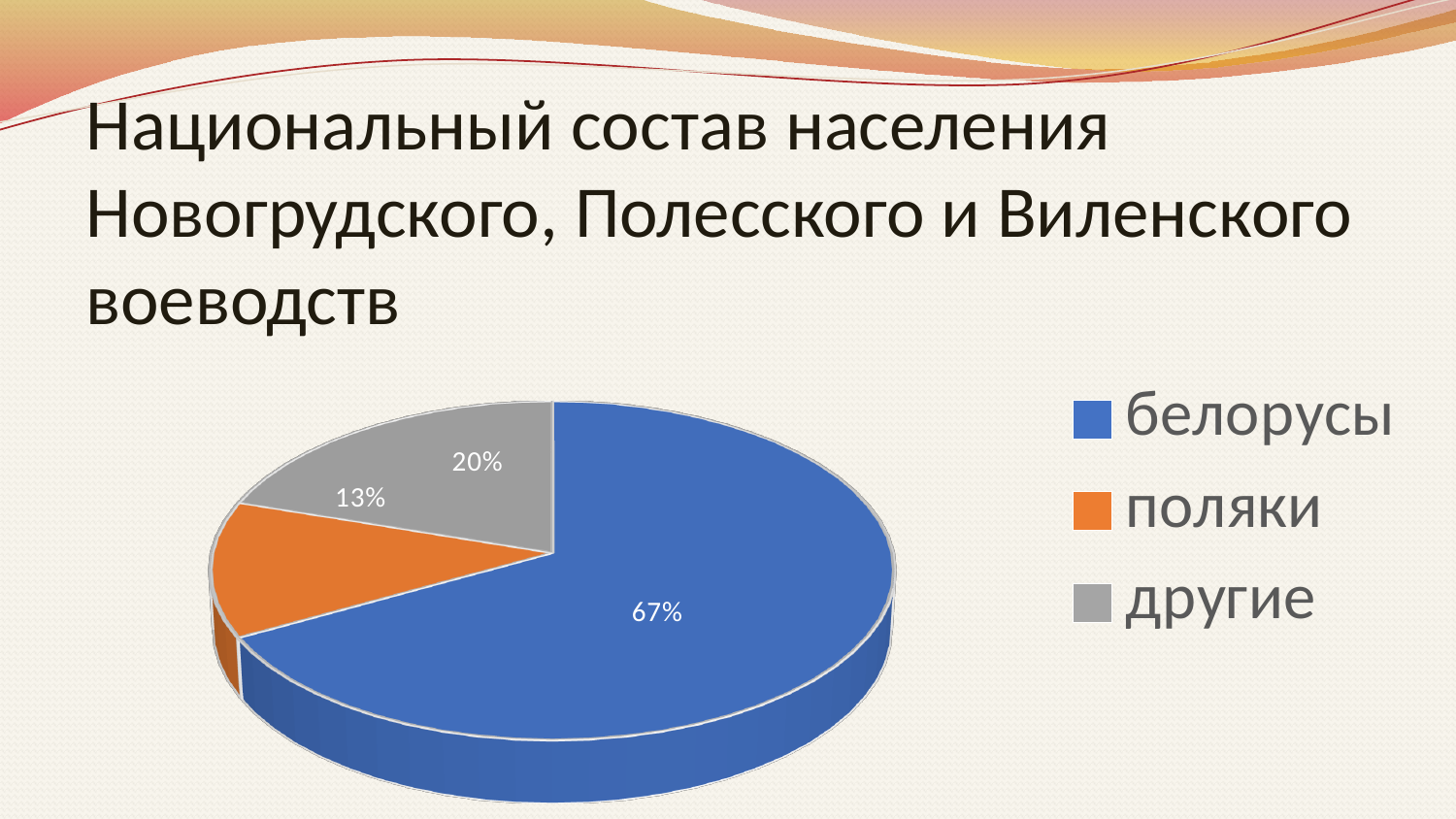
How many slices does the pie chart have? 3 Which slice is larger, поляки or другие? другие Which category has the smallest slice in the pie chart? поляки What share of the pie chart is labelled for другие? 20% What share of the pie chart is labelled for белорусы? 67% What kind of chart is shown on the slide? pie chart What is the difference in percentage points between the другие slice and the поляки slice? 7 What colour is the slice for поляки in the pie chart? orange Which category has the largest slice in the pie chart? белорусы What is the difference in percentage points between the белорусы slice and the другие slice? 47 What share of the pie chart is labelled for поляки? 13% How many entries does the legend list? 3